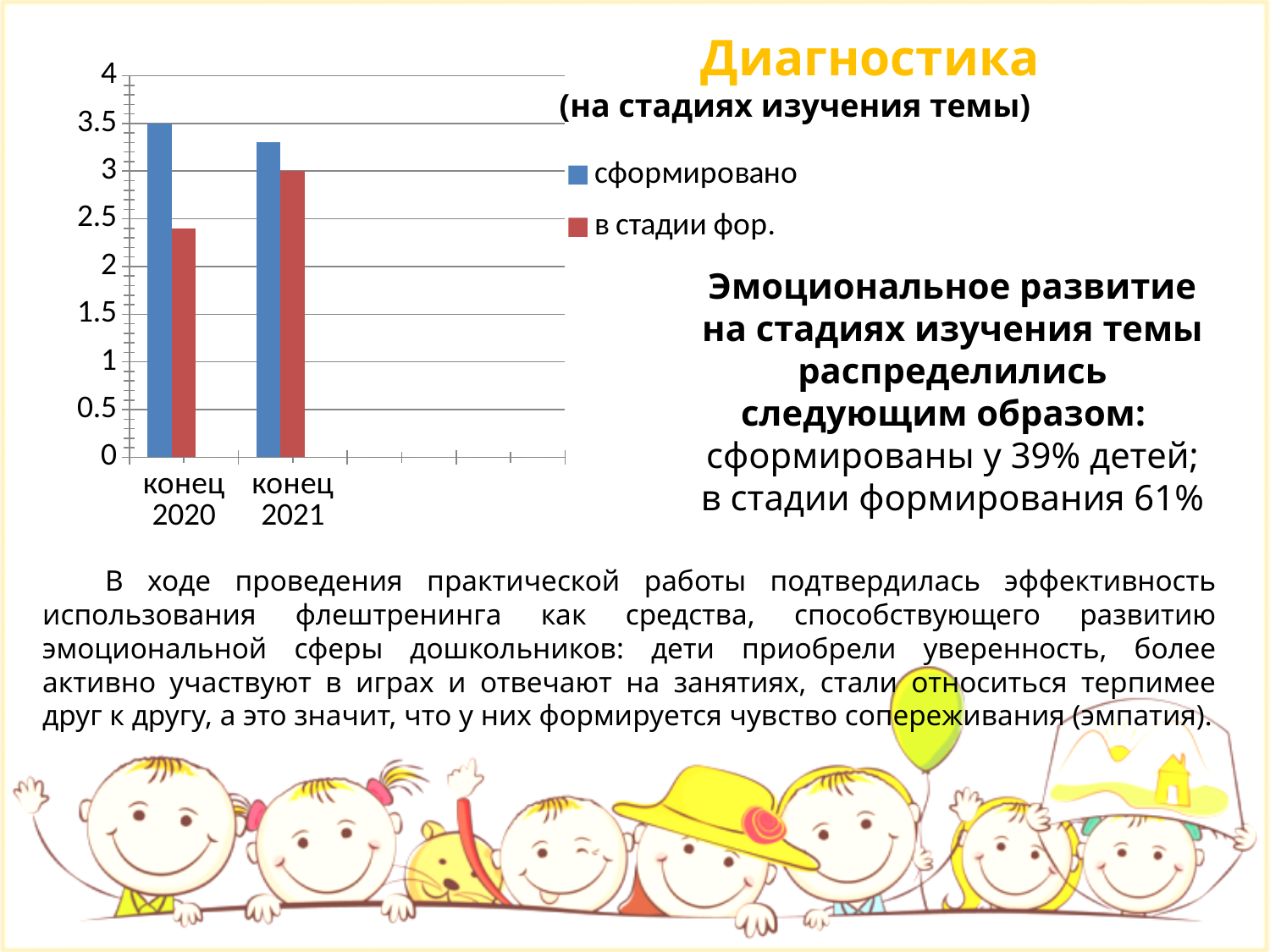
Which category has the lowest value for 'в стадии фор.'? конец 2020 How many categories are shown on the x axis of the chart? 2 Does the value for 'в стадии фор.' rise or fall from 'конец 2020' to 'конец 2021'? rise What is the value for 'в стадии фор.' at 'конец 2021'? 3 Which category has the highest value for 'сформировано'? конец 2020 Which colour represents the 'в стадии фор.' series in the chart? red What is the value for 'сформировано' at 'конец 2020'? 3.5 How many series does the chart legend list? 2 Is the value for 'сформировано' at 'конец 2021' greater or less than 3? greater What kind of chart is shown on the slide? bar chart Which is larger at 'конец 2020': 'сформировано' or 'в стадии фор.'? сформировано Is the value for 'в стадии фор.' at 'конец 2020' greater or less than 2.5? less